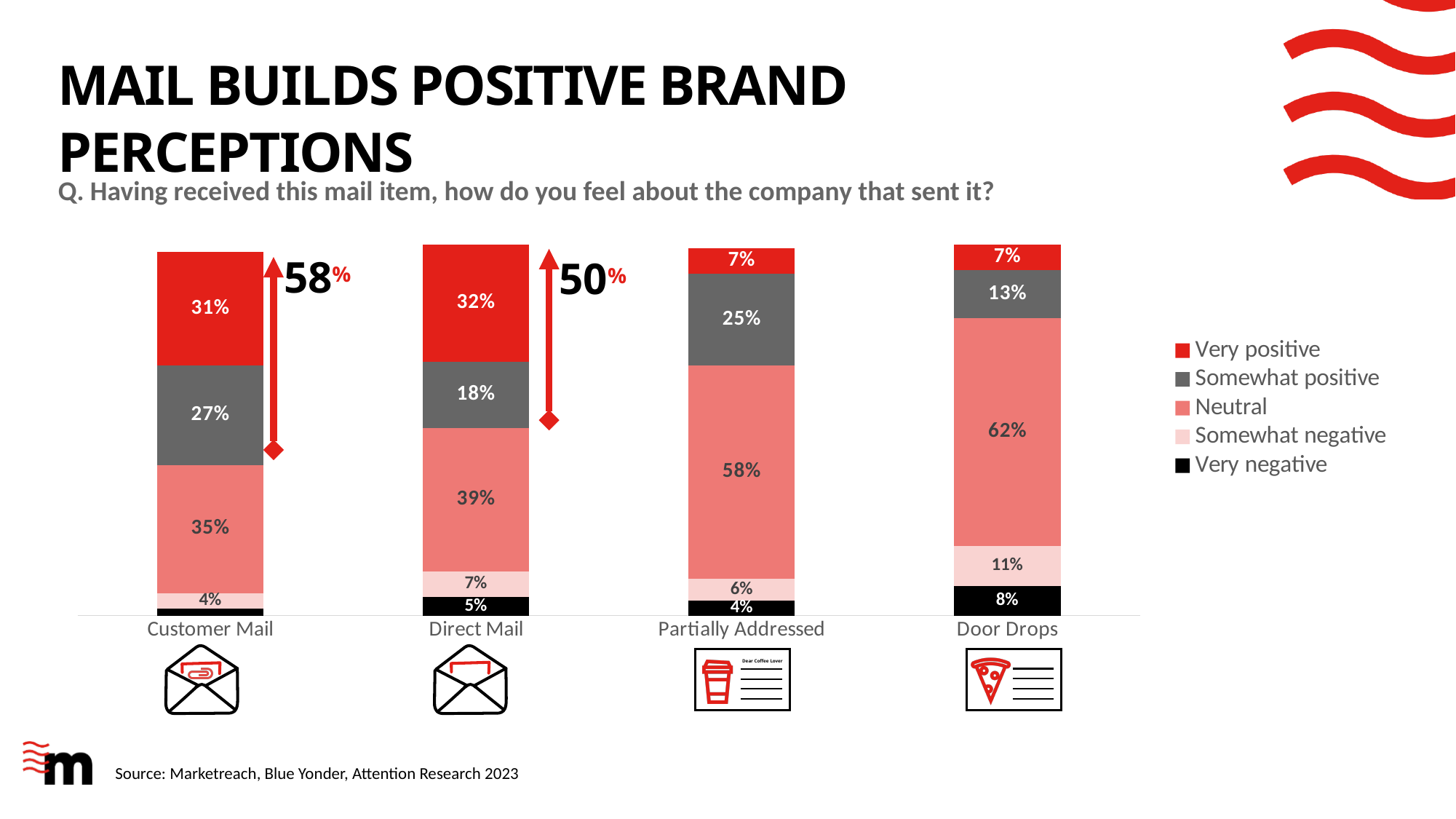
Which has a larger Somewhat negative value, Door Drops or Direct Mail? Door Drops What is the Somewhat positive value for Partially Addressed mail? 25% Which mail type has the lowest Neutral percentage? Customer Mail What is the Very negative value for Door Drops? 8% How many mail types are shown on the x axis? 4 How many series does the legend list? 5 What percentage of respondents felt Neutral about the company after receiving Door Drops? 62% What combined positive percentage is annotated next to the Customer Mail bar? 58% Which mail type has the highest Very positive percentage? Direct Mail What kind of chart is shown on the slide? Stacked bar chart How much higher is the Neutral value for Door Drops than for Partially Addressed? 4% What is the Very positive value for Direct Mail? 32%